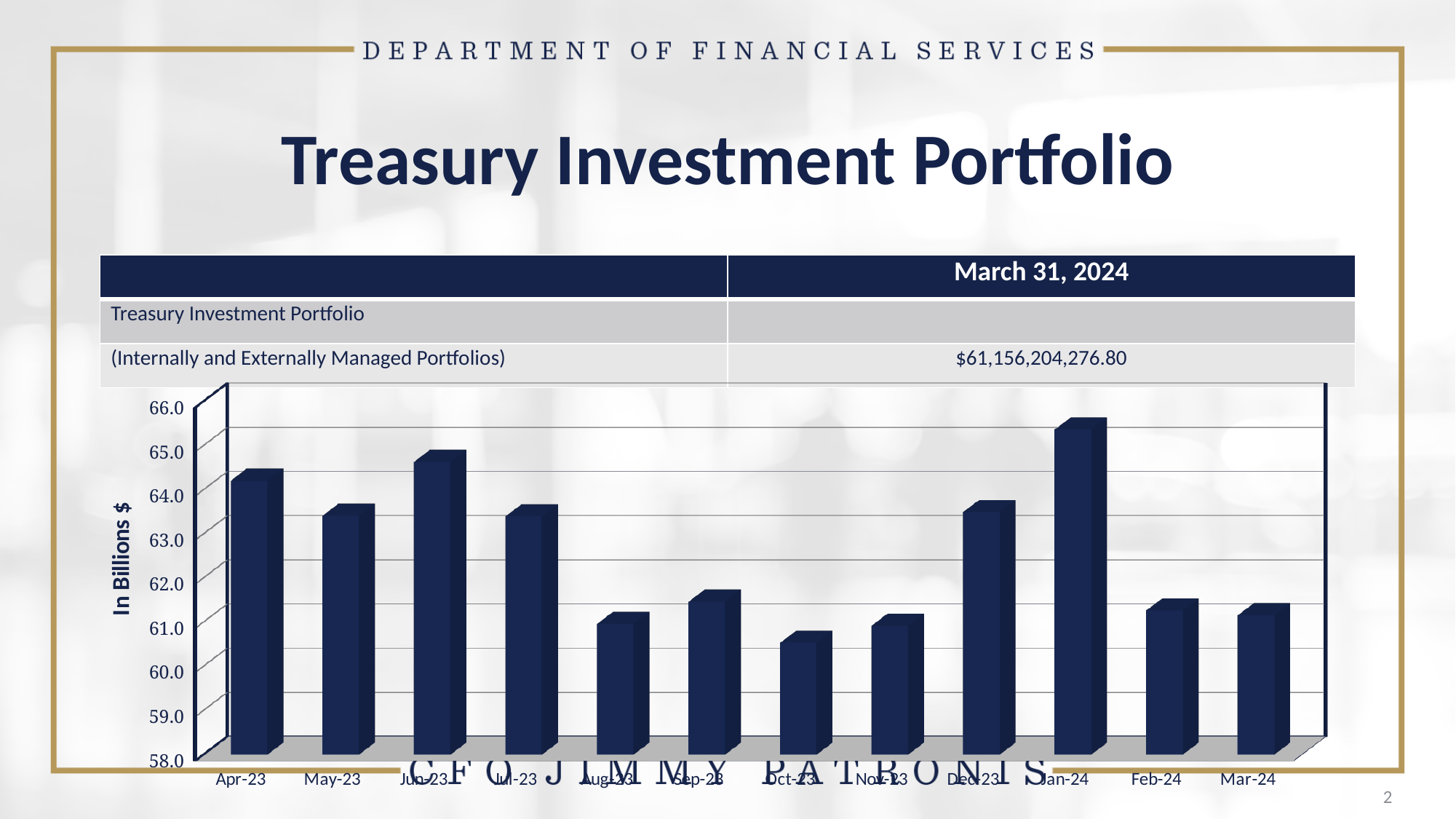
Is the value for Jan-24 greater or less than 64.0? greater Which is larger, the value for Jun-23 or the value for May-23? Jun-23 Is the value for Aug-23 greater or less than 62.0? less What kind of chart is shown on the slide? bar chart Which is larger, the value for Apr-23 or the value for Aug-23? Apr-23 What is the label on the vertical axis of the chart? In Billions $ Which month has the highest value on the chart? Jan-24 How many months are plotted on the chart? 12 From Jun-23 to Oct-23, do the values rise or fall? fall Is the value for Oct-23 greater or less than 61.0? less Which month has the lowest value on the chart? Oct-23